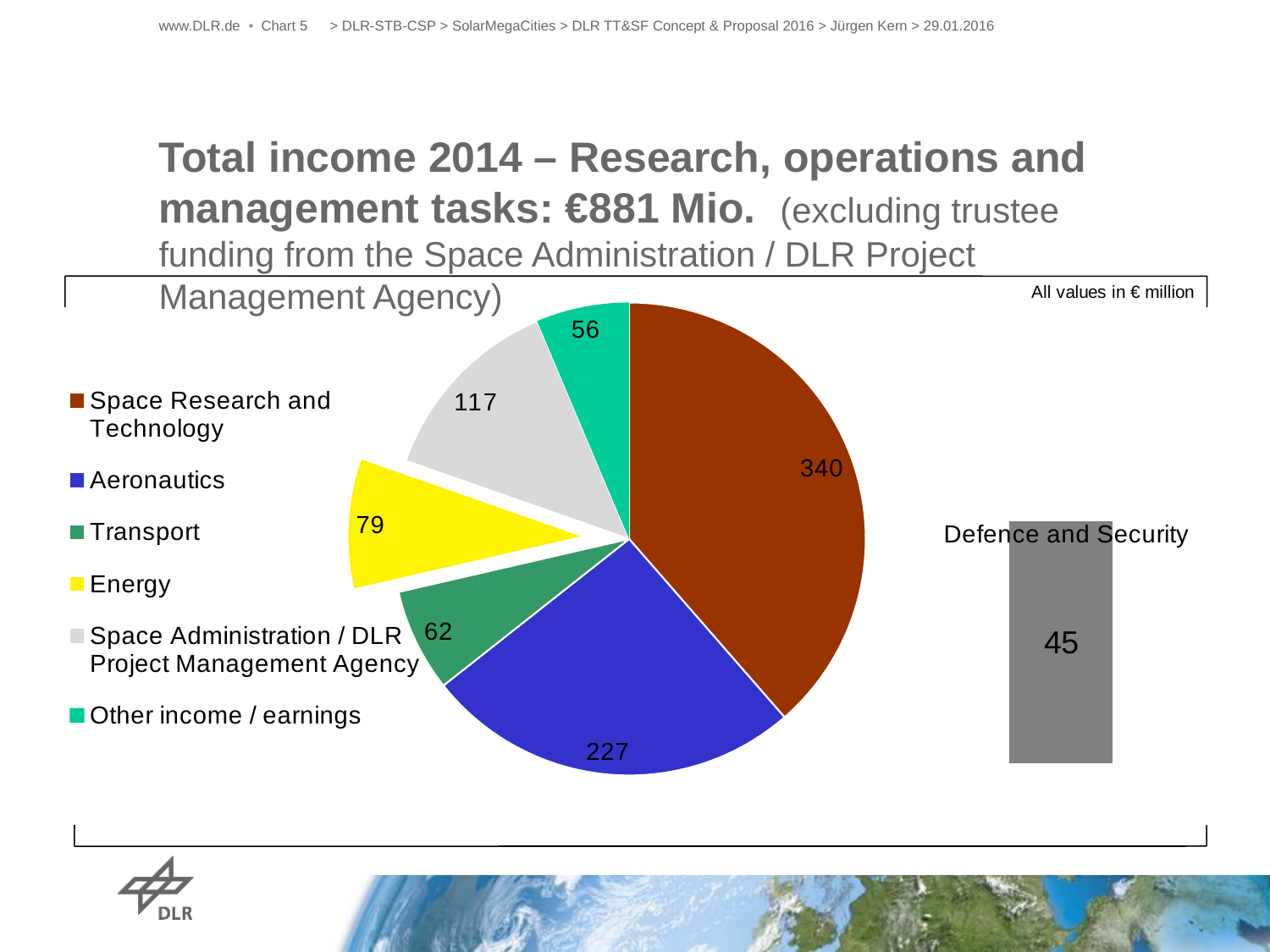
In the pie chart, which is larger, Transport or Energy? Energy What kind of chart is the main chart on the slide? Pie chart In the pie chart, what is the value for Aeronautics? 227 In the pie chart, what is the value for Space Administration / DLR Project Management Agency? 117 In the Defence and Security bar chart on the right, what value is shown? 45 In the pie chart, what is the total of all slices? 881 How many entries does the legend of the pie chart list? 6 In the pie chart, which category has the largest value? Space Research and Technology In the pie chart, what is the value for Energy? 79 In the pie chart, which category has the smallest value? Other income / earnings How many slices does the pie chart have? 6 In the pie chart, what is the difference between Space Research and Technology and Aeronautics? 113